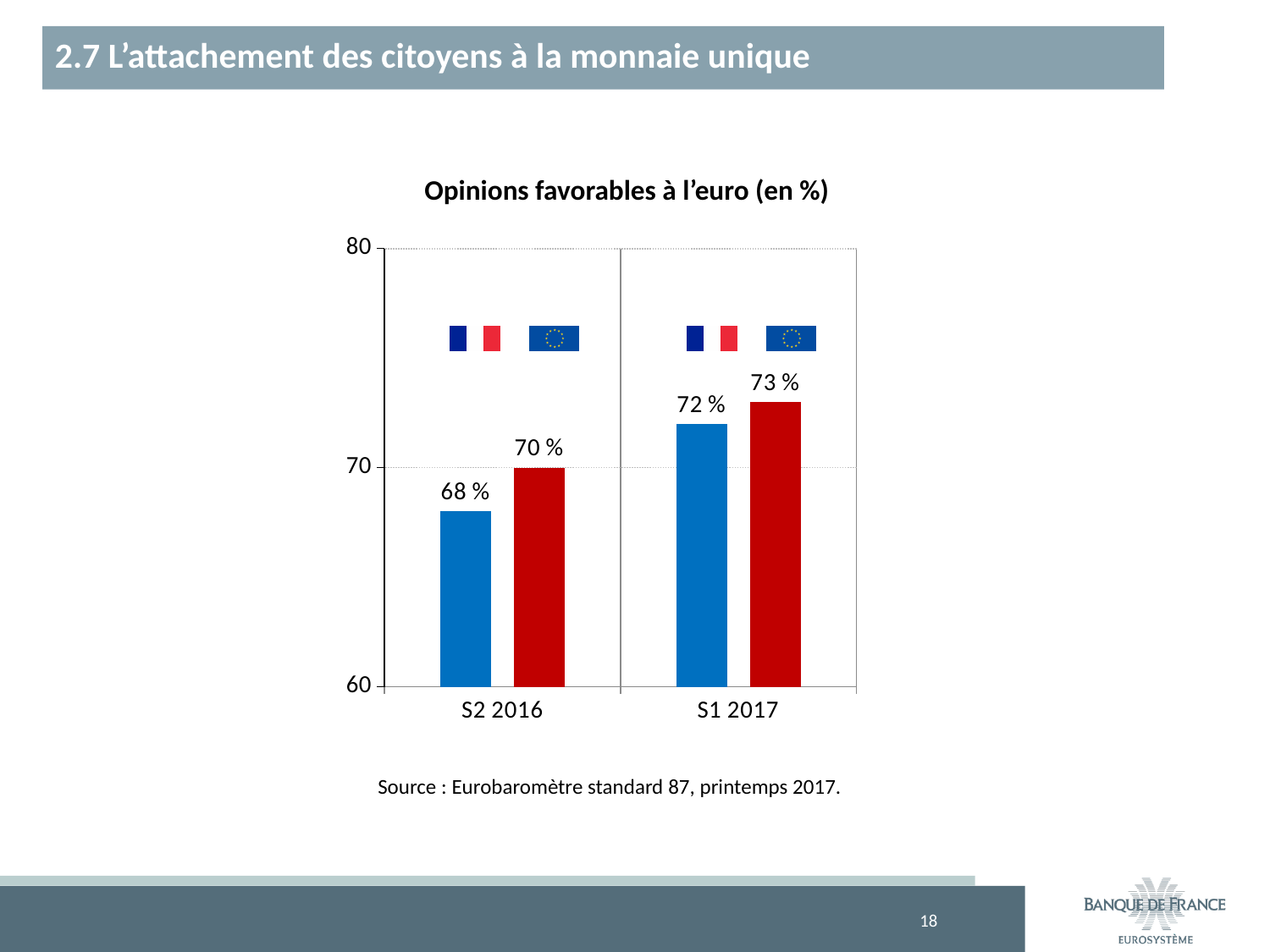
What is the difference between the blue bar values for S1 2017 and S2 2016? 4 % Which bar has the highest value on the chart? The red bar for S1 2017 (73 %) What is the value of the blue bar for S1 2017? 72 % What kind of chart is shown on the slide? Bar chart Which bar has the lowest value on the chart? The blue bar for S2 2016 (68 %) What is the value of the red bar for S1 2017? 73 % What is the value of the blue bar for S2 2016? 68 % Do the blue bar values rise or fall from S2 2016 to S1 2017? Rise Which is larger for S1 2017, the blue bar or the red bar? The red bar What is the difference between the red bar and the blue bar for S2 2016? 2 % How many categories are shown on the x axis? 2 What is the value of the red bar for S2 2016? 70 %